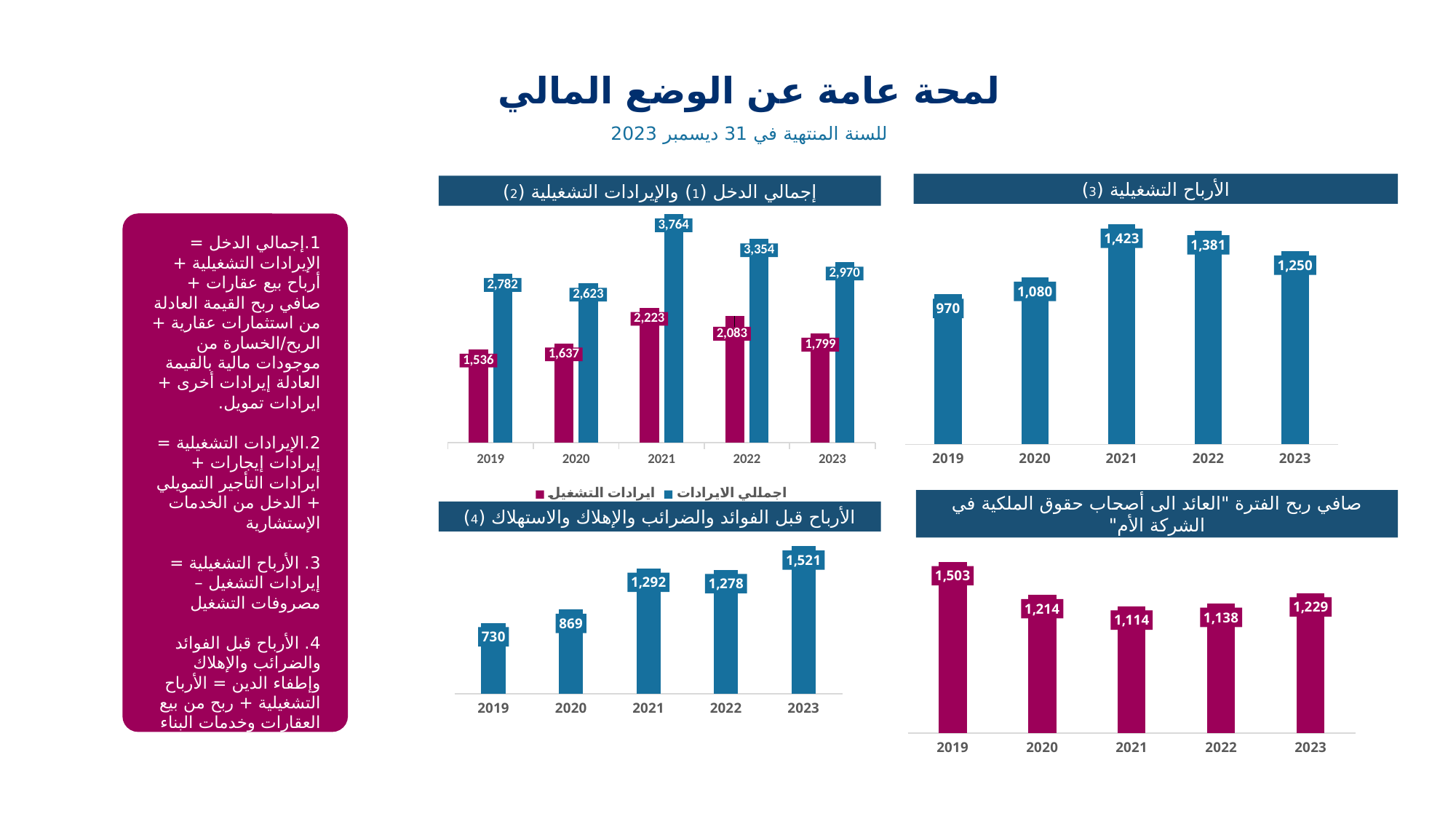
In the bottom-left chart (الأرباح قبل الفوائد والضرائب والإهلاك والاستهلاك), what is the value for 2019? 730 In the top-left chart (إجمالي الدخل والإيرادات التشغيلية), what is the value of the اجمالي الايرادات series for 2021? 3,764 In the bottom-left chart (الأرباح قبل الفوائد والضرائب والإهلاك والاستهلاك), which year has the highest value? 2023 In the top-left chart (إجمالي الدخل والإيرادات التشغيلية), which is larger: the ايرادات التشغيل value for 2021 or for 2022? 2021 In the top-left chart (إجمالي الدخل والإيرادات التشغيلية), what is the value of the ايرادات التشغيل series for 2019? 1,536 How many years are shown on the x axis of the bottom-right chart (صافي ربح الفترة)? 5 In the bottom-right chart (صافي ربح الفترة), which year has the highest value? 2019 In the top-right chart (الأرباح التشغيلية), what is the difference between the 2021 and 2023 values? 173 In the bottom-right chart (صافي ربح الفترة), what is the value for 2020? 1,214 How many series does the legend of the top-left chart (إجمالي الدخل والإيرادات التشغيلية) list? 2 In the top-right chart (الأرباح التشغيلية), which year has the lowest value? 2019 In the top-right chart (الأرباح التشغيلية), what is the value for 2021? 1,423